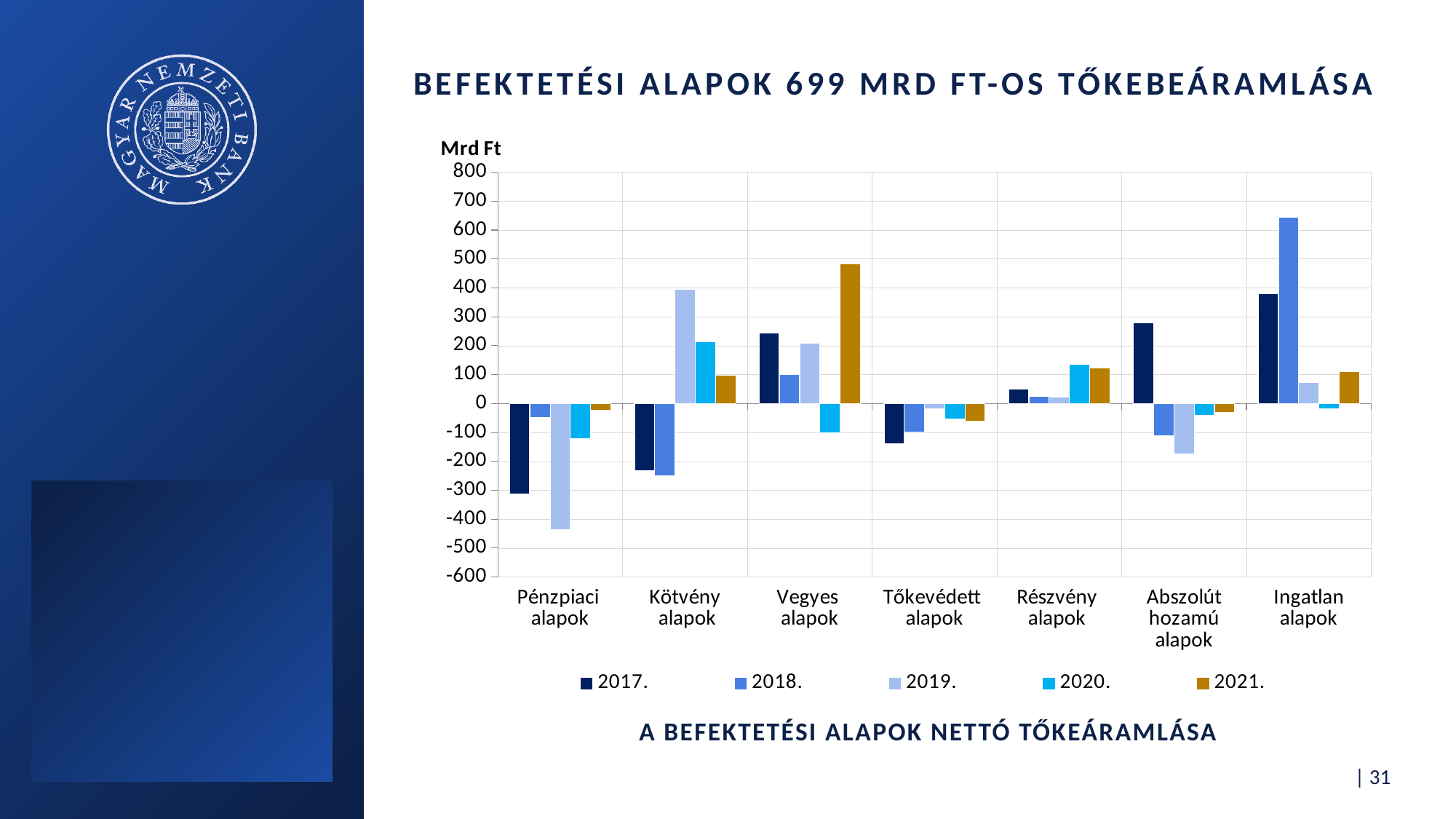
What unit is shown above the vertical axis? Mrd Ft Which fund category has the highest value for 2021? Vegyes alapok Is the 2019 value for Kötvény alapok greater or less than 300? greater How many series does the legend list? 5 What is the caption printed below the chart? A BEFEKTETÉSI ALAPOK NETTÓ TŐKEÁRAMLÁSA What kind of chart is shown on the slide? bar chart Which fund category has the lowest value for 2019? Pénzpiaci alapok Is the 2021 value for Vegyes alapok greater or less than 400? greater Which is larger: the 2017 value for Ingatlan alapok or the 2017 value for Abszolút hozamú alapok? Ingatlan alapok Which fund category has the highest value for 2018? Ingatlan alapok How many fund categories are shown on the x axis? 7 Is the 2017 value for Pénzpiaci alapok greater or less than -200? less